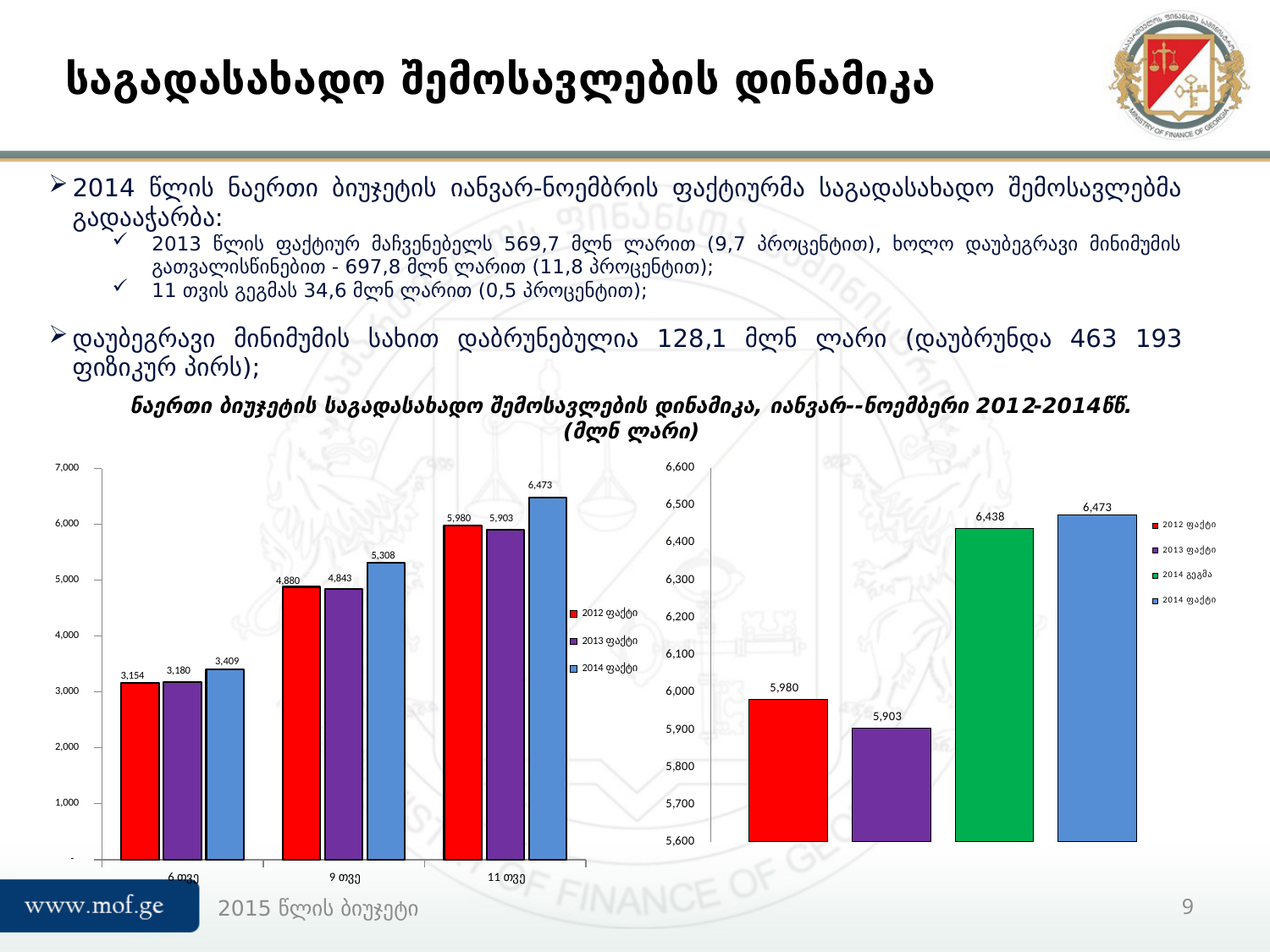
In the left chart, what is the value for 2014 ფაქტი at 11 თვე? 6,473 What kind of chart is the right chart? bar chart In the left chart, how many series does the legend list? 3 In the left chart, what is the difference between 2014 ფაქტი and 2012 ფაქტი at 9 თვე? 428 In the left chart, do the values for 2014 ფაქტი rise or fall from 6 თვე to 11 თვე? rise In the right chart, what is the value for 2014 გეგმა? 6,438 In the right chart, which bar is the lowest? 2013 ფაქტი In the right chart, what is the difference between 2014 ფაქტი and 2014 გეგმა? 35 In the left chart, how many categories are shown on the x axis? 3 In the left chart, what is the value for 2013 ფაქტი at 9 თვე? 4,843 In the left chart, what is the value for 2012 ფაქტი at 6 თვე? 3,154 In the right chart, which bar is the highest? 2014 ფაქტი